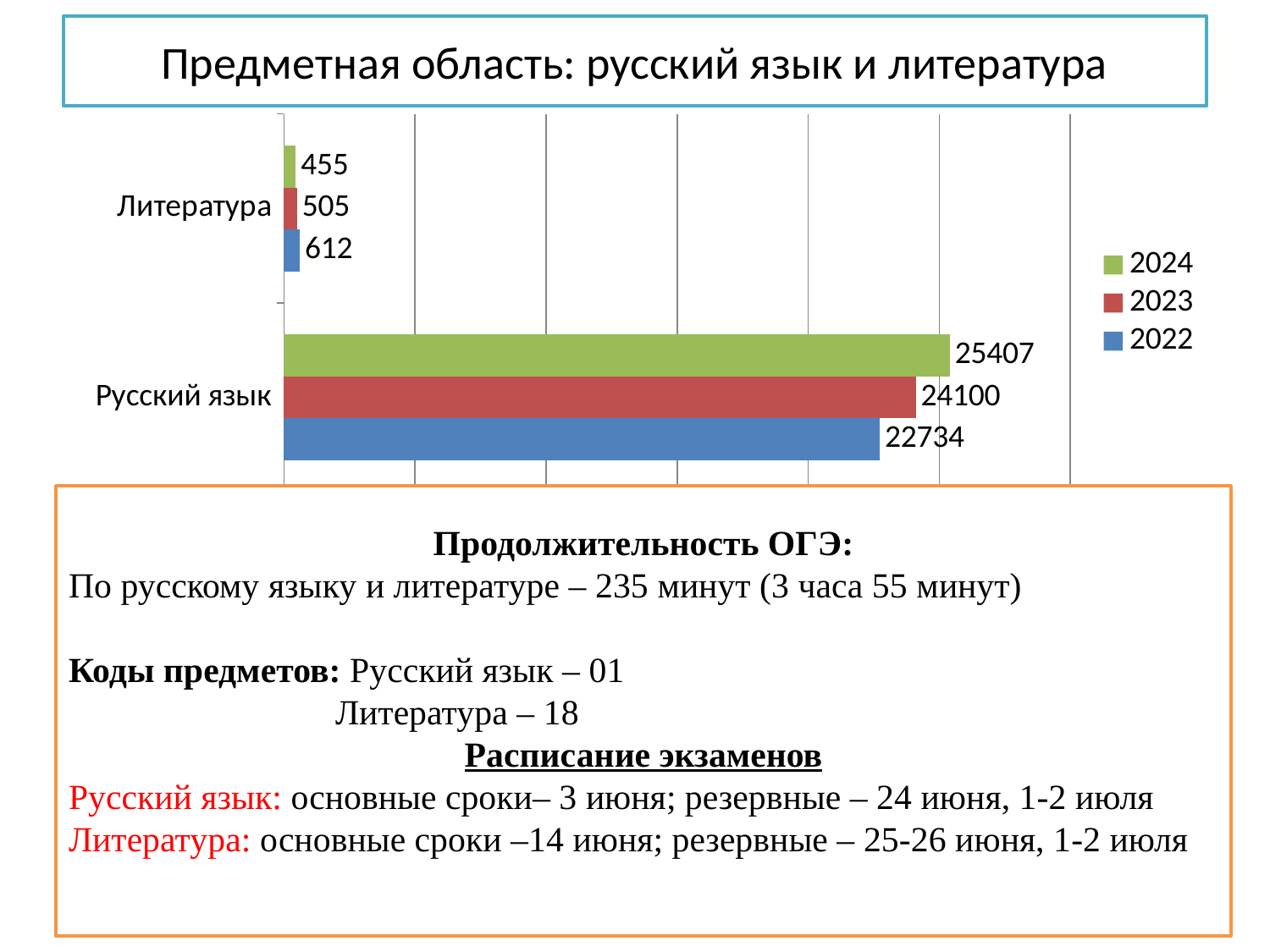
Which year has the highest value for Русский язык? 2024 What is the difference between the 2024 and 2022 values for Русский язык? 2673 What is the value for Русский язык in the 2024 series? 25407 What is the value for Литература in the 2023 series? 505 Which is larger for Литература: the 2023 value or the 2022 value? 2022 Which year has the lowest value for Литература? 2024 How many categories are shown on the chart? 2 What is the value for Русский язык in the 2022 series? 22734 How many series does the legend list? 3 What is the value for Литература in the 2022 series? 612 What kind of chart is shown on the slide? Bar chart What is the difference between the 2022 and 2024 values for Литература? 157